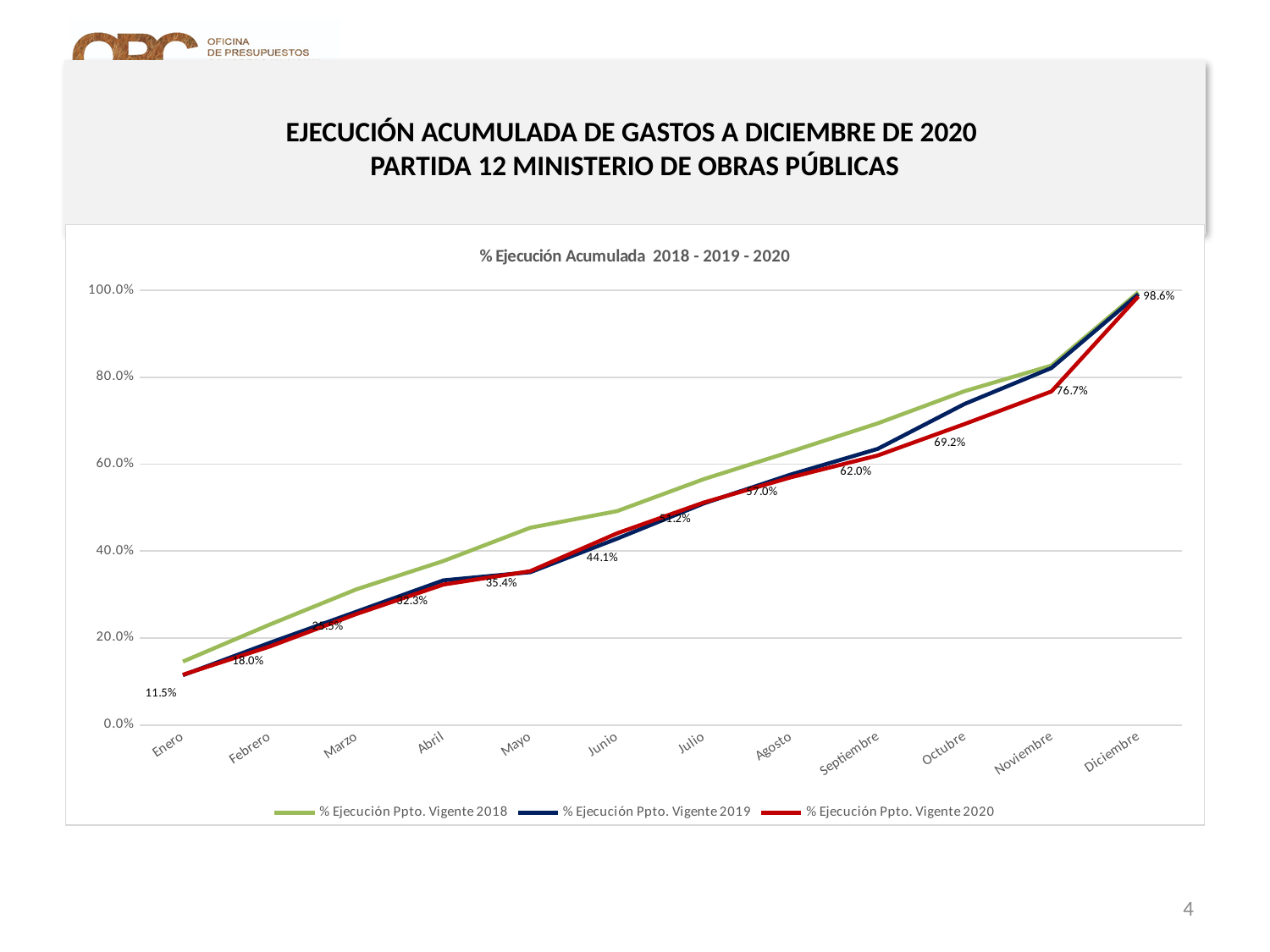
What is the value for % Ejecución Ppto. Vigente 2020 in Enero? 11.5% What is the value for % Ejecución Ppto. Vigente 2020 in Diciembre? 98.6% What is the title of the chart? % Ejecución Acumulada 2018 - 2019 - 2020 Do the values for % Ejecución Ppto. Vigente 2020 rise or fall from Enero to Diciembre? Rise What kind of chart is shown on the slide? Line chart How many series does the legend list? 3 In Enero, which series has the larger value: % Ejecución Ppto. Vigente 2018 or % Ejecución Ppto. Vigente 2020? % Ejecución Ppto. Vigente 2018 What is the difference between the 2020 values for Diciembre and Noviembre? 21.9 percentage points What is the value for % Ejecución Ppto. Vigente 2020 in Noviembre? 76.7% How many months are shown along the x axis? 12 Is the value for % Ejecución Ppto. Vigente 2018 in Mayo greater or less than 40.0%? greater What is the difference between the 2020 values for Octubre and Septiembre? 7.2 percentage points